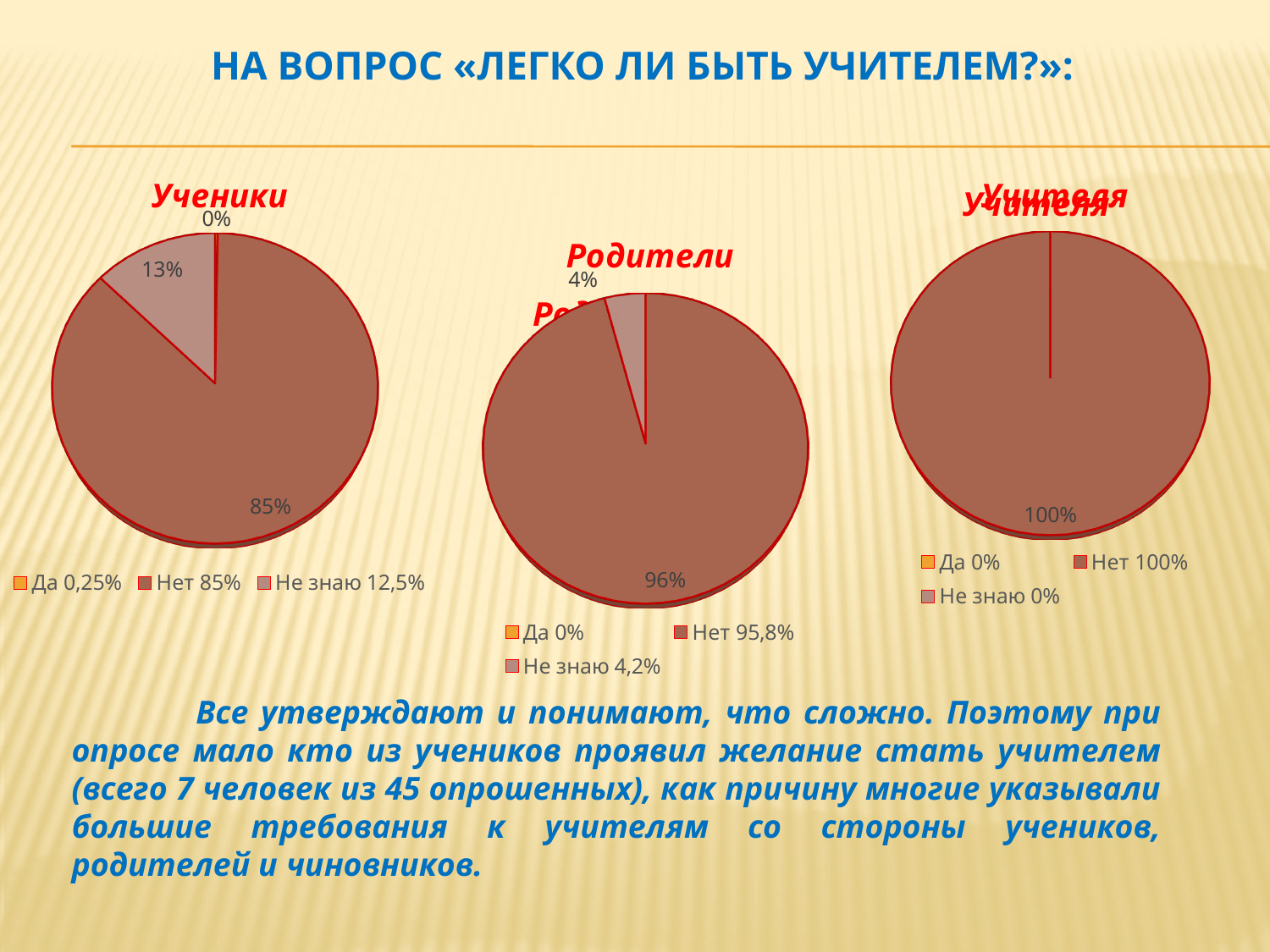
In the "Родители" pie chart, what percentage label is shown on the small "Не знаю" slice? 4% In the "Ученики" pie chart, what percentage label is shown on the largest slice? 85% Which is larger in the "Ученики" pie chart: the "Нет" slice or the "Не знаю" slice? Нет In the "Ученики" pie chart, what percentage label is shown on the "Не знаю" slice? 13% In the "Родители" pie chart, what percentage label is shown on the largest slice? 96% What is the title of the middle pie chart? Родители What kind of chart is used for the "Ученики" chart on the left? pie chart In the "Родители" pie chart, which category has the smallest share according to the legend? Да How many categories does the legend of the "Учителя" pie chart list? 3 In the "Учителя" pie chart on the right, what percentage label is shown on the pie? 100% According to the legend of the "Родители" pie chart, what is the value for "Нет"? 95,8% In the "Ученики" pie chart, which category has the largest slice? Нет